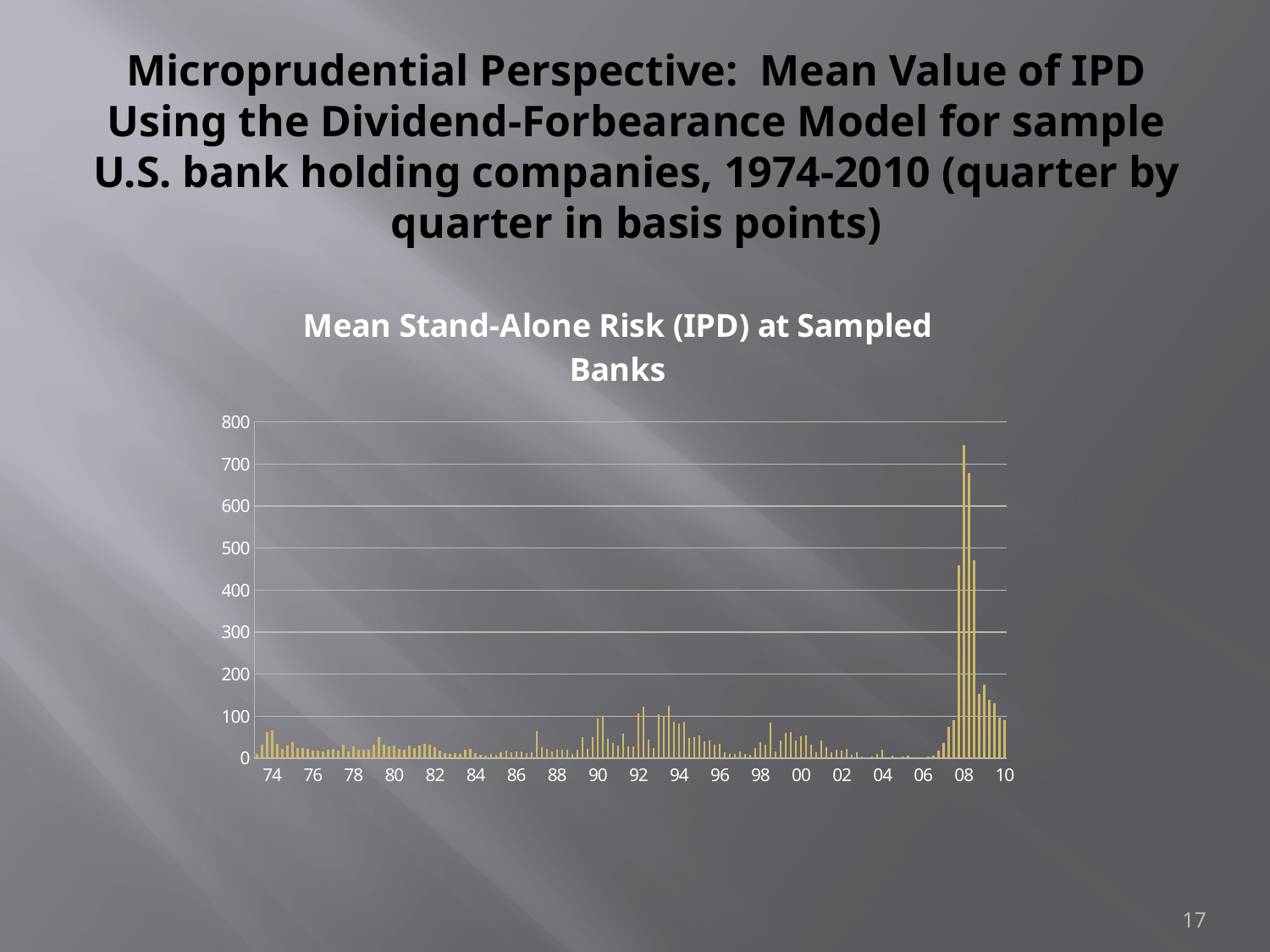
Is the value of the tallest bar in the chart greater or less than 800? less How many year labels are shown on the x axis? 19 What is the last year label shown on the x axis? 10 Which period has larger bars: around 1980 or around 2008? around 2008 What kind of chart is shown on the slide? bar chart In which year labelled on the x axis does the tallest bar of the chart occur? 08 Are the bars for the years 1974 through 1986 greater or less than 100? less Is the value of the bar at 1992 that stands out above its neighbours greater or less than 200? less What is the first year label shown on the x axis? 74 What is the title of the chart? Mean Stand-Alone Risk (IPD) at Sampled Banks What is the highest value shown on the y axis? 800